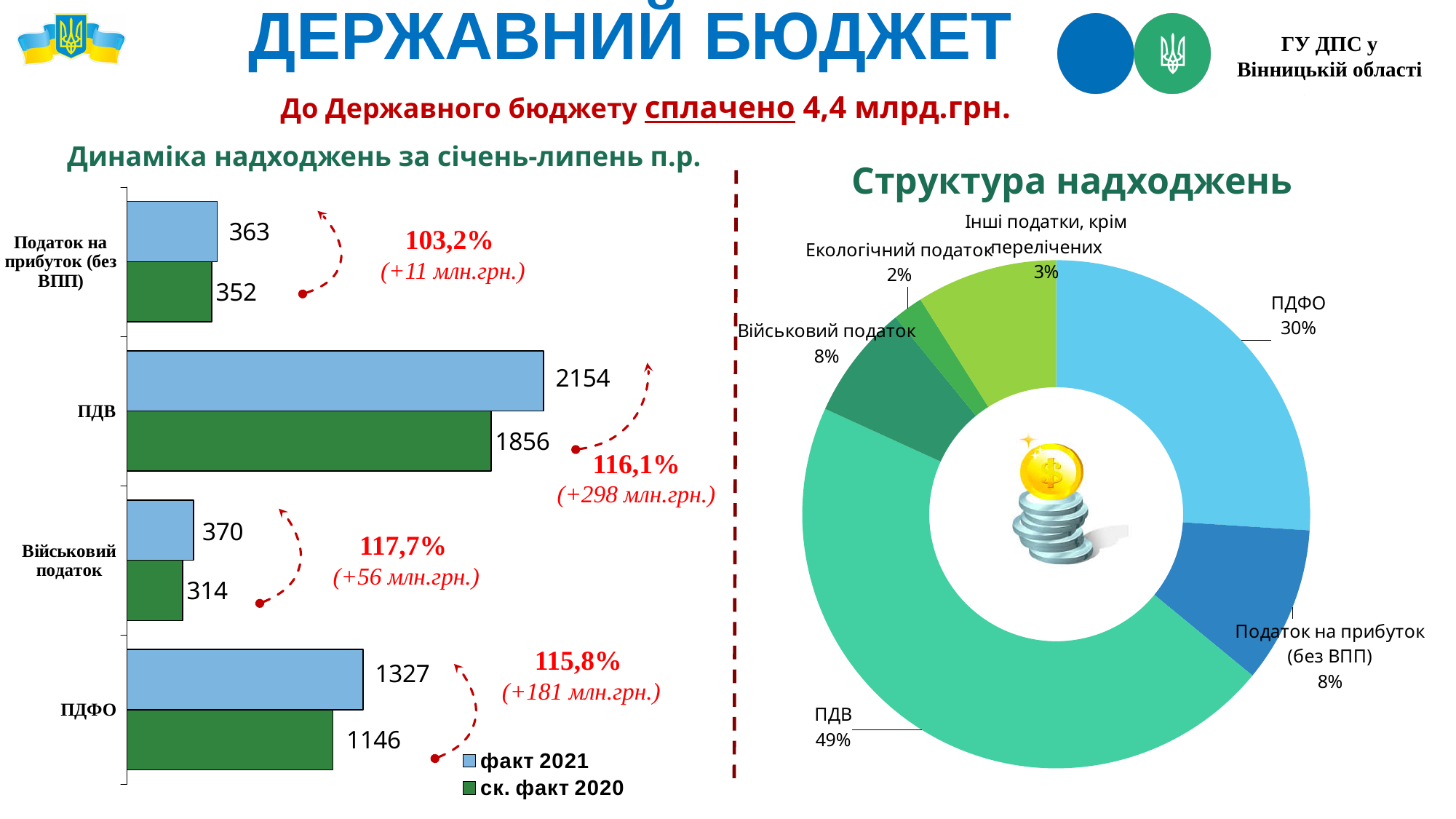
In the bar chart 'Динаміка надходжень за січень-липень п.р.', how many series does the legend list? 2 In the bar chart 'Динаміка надходжень за січень-липень п.р.', how many categories are shown? 4 In the bar chart 'Динаміка надходжень за січень-липень п.р.', what is the value for ПДФО in the 'ск. факт 2020' series? 1146 In the bar chart 'Динаміка надходжень за січень-липень п.р.', what is the value for Військовий податок in the 'факт 2021' series? 370 In the chart 'Структура надходжень', what share does ПДВ have? 49% What kind of chart is 'Структура надходжень'? Doughnut chart In the chart 'Структура надходжень', which category has the smallest share? Екологічний податок In the bar chart 'Динаміка надходжень за січень-липень п.р.', which category has the lowest 'ск. факт 2020' value? Військовий податок In the bar chart 'Динаміка надходжень за січень-липень п.р.', what is the value for ПДВ in the 'факт 2021' series? 2154 In the chart 'Структура надходжень', which is larger: the share of ПДФО or the share of Військовий податок? ПДФО In the bar chart 'Динаміка надходжень за січень-липень п.р.', what is the difference between the 'факт 2021' and 'ск. факт 2020' values for ПДВ? 298 In the bar chart 'Динаміка надходжень за січень-липень п.р.', which category has the highest 'факт 2021' value? ПДВ